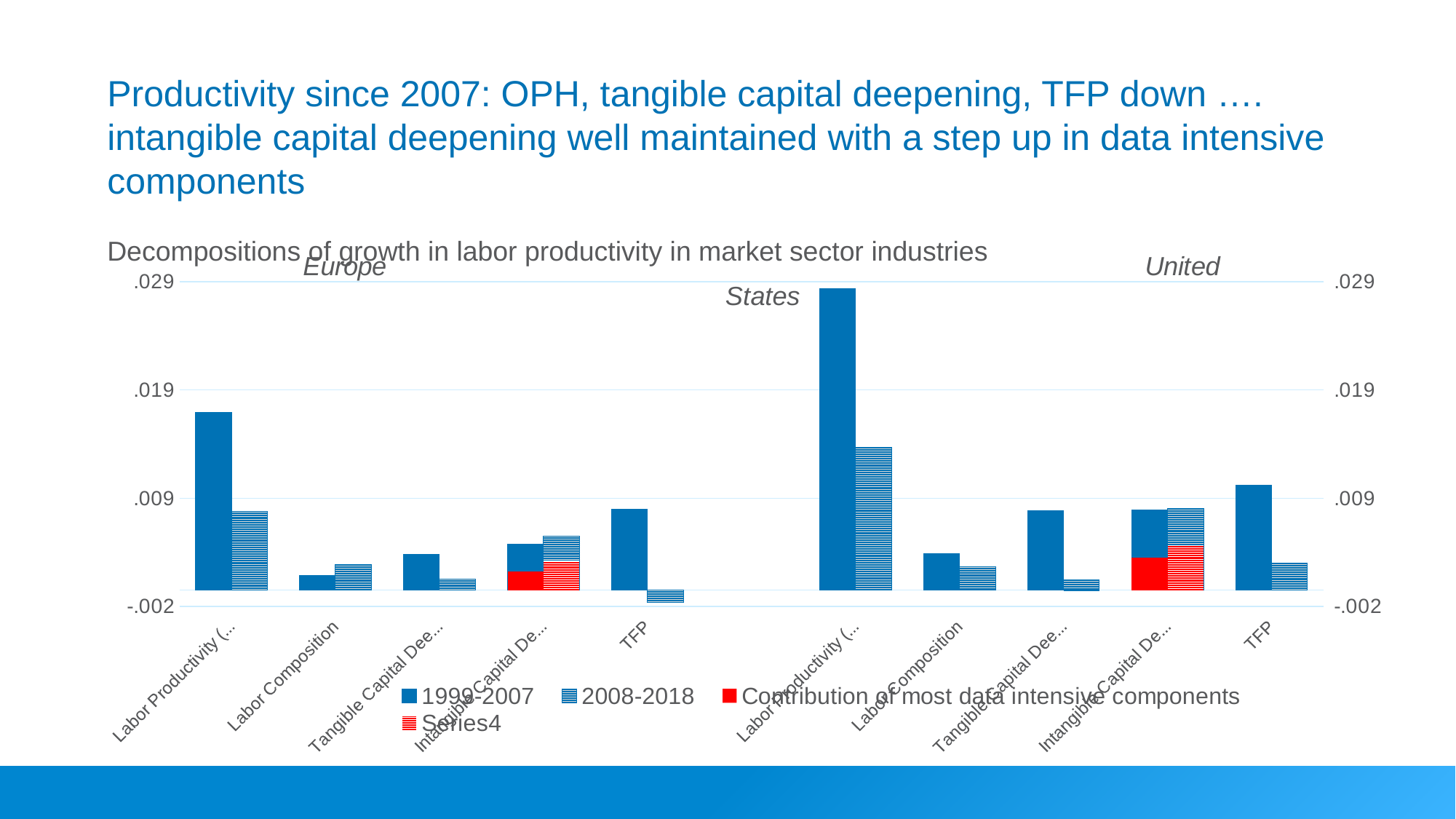
What kind of chart is shown on the slide? bar chart How many categories are plotted in the Europe panel of the chart? 5 In the United States panel, is the 1999-2007 value for Labor Productivity greater or less than .019? greater How many series does the chart legend list? 4 In the Europe panel, is the 1999-2007 value for Labor Productivity greater or less than .019? less Which two regions are labelled on the chart? Europe and United States In the Europe panel, which category has the lowest 2008-2018 bar? TFP In the Europe panel, which is larger for Labor Productivity: the 1999-2007 bar or the 2008-2018 bar? 1999-2007 In the Europe panel, is the 2008-2018 value for TFP greater or less than .009? less In the United States panel, which category has the highest 1999-2007 bar? Labor Productivity In the United States panel, which is larger for TFP: the 1999-2007 bar or the 2008-2018 bar? 1999-2007 What is the title of the chart? Decompositions of growth in labor productivity in market sector industries